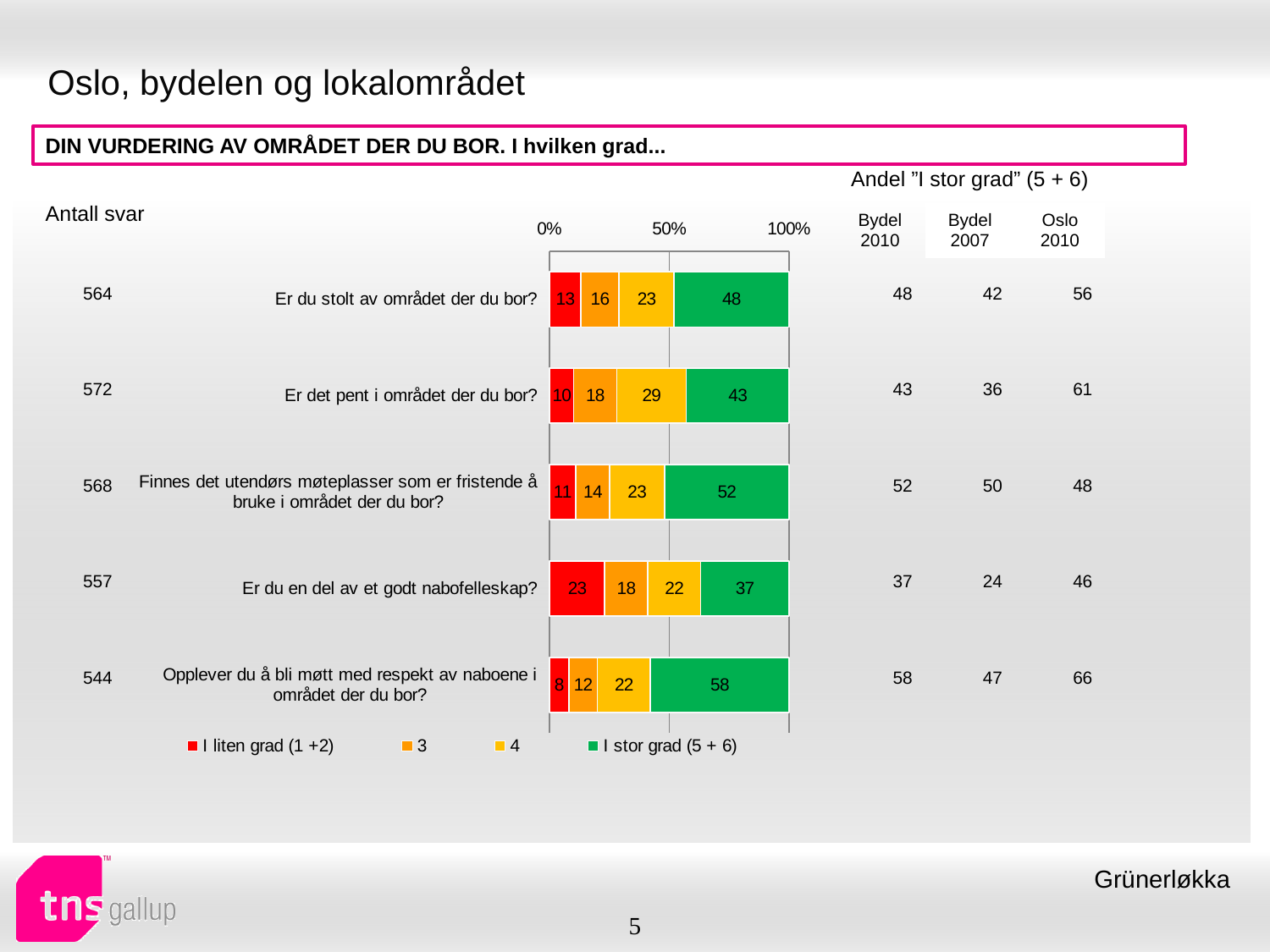
How many question categories are plotted in the chart? 5 What is the difference between the "I stor grad (5 + 6)" values for "Finnes det utendørs møteplasser som er fristende å bruke i området der du bor?" and "Er du en del av et godt nabofelleskap?"? 15 How many series does the chart legend list? 4 What is the value of "I liten grad (1 +2)" for "Er du en del av et godt nabofelleskap?"? 23 Which is larger: the "3" value for "Er det pent i området der du bor?" or the "3" value for "Er du stolt av området der du bor?"? Er det pent i området der du bor? Which category has the lowest value for "I liten grad (1 +2)"? Opplever du å bli møtt med respekt av naboene i området der du bor? What is the value of "I stor grad (5 + 6)" for "Er du stolt av området der du bor?"? 48 What colour represents "I stor grad (5 + 6)" in the chart? Green What type of chart is shown on the slide? Stacked bar chart Which category has the highest value for "I stor grad (5 + 6)"? Opplever du å bli møtt med respekt av naboene i området der du bor? What is the total of the stacked bar for "Er du stolt av området der du bor?"? 100 What is the value of series "4" for "Er det pent i området der du bor?"? 29